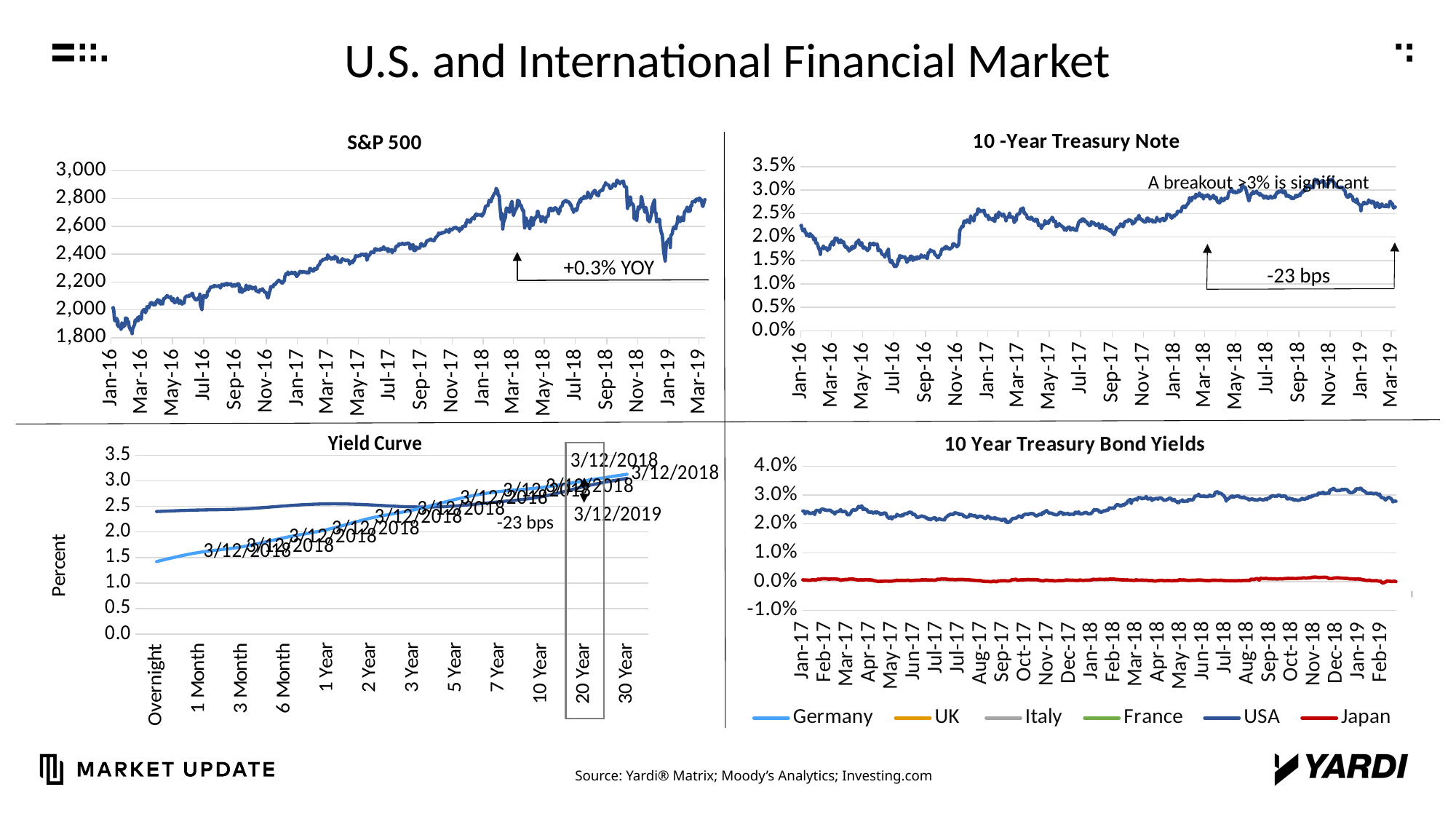
On the 10-Year Treasury Note chart, is the yield in Mar-19 greater or less than 2.5%? greater On the Yield Curve chart, which series has the higher value at Overnight, 3/12/2018 or 3/12/2019? 3/12/2019 On the S&P 500 chart, does the index generally rise or fall from Jan-16 to Mar-19? rise On the 10 Year Treasury Bond Yields chart, which country has the higher yield in Feb-19, USA or Japan? USA What kind of chart is the S&P 500 chart? line chart On the 10-Year Treasury Note chart, what change in basis points is annotated between Mar-18 and Mar-19? -23 bps On the S&P 500 chart, is the value in Mar-19 greater or less than 2,600? greater On the 10 Year Treasury Bond Yields chart, is the USA yield in Feb-19 greater or less than 2.0%? greater How many maturity categories are shown on the x axis of the Yield Curve chart? 12 How many series does the legend of the 10 Year Treasury Bond Yields chart list? 6 On the S&P 500 chart, what year-over-year change is annotated? +0.3% YOY